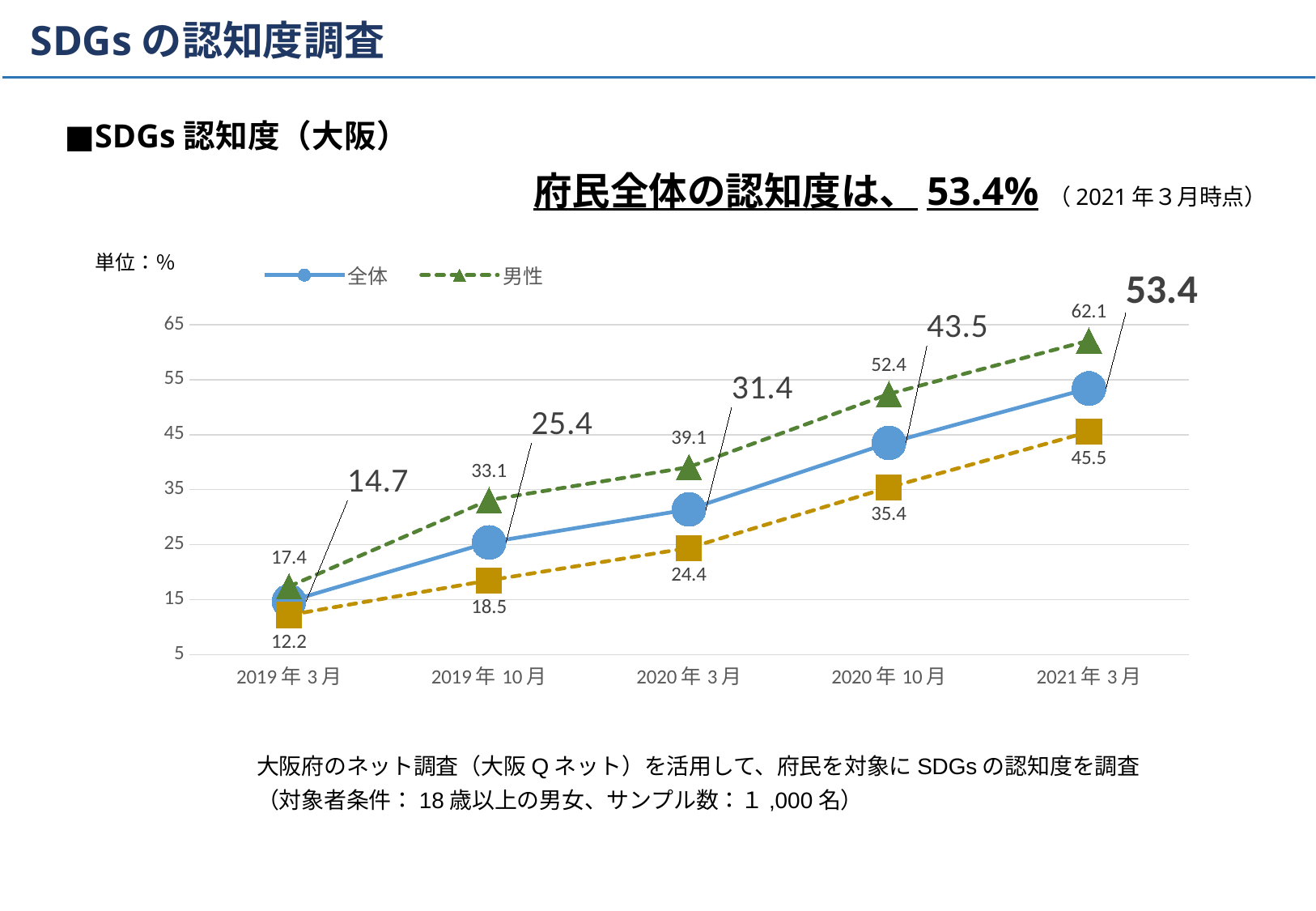
What is the value for 全体 at 2021年3月? 53.4 What is the value for 男性 at 2020年10月? 52.4 At which time point is the 男性 value lowest? 2019年3月 How many time points are plotted on the x axis? 5 What is the value for 全体 at 2019年3月? 14.7 At 2020年3月, which is larger, the 全体 value or the 男性 value? 男性 At which time point is the 全体 value highest? 2021年3月 Does the 全体 value rise or fall from 2019年3月 to 2021年3月? rise What is the difference between the 男性 and 全体 values at 2021年3月? 8.7 By how much did the 全体 value increase from 2019年3月 to 2021年3月? 38.7 What is the value for 男性 at 2019年10月? 33.1 How many series does the legend list? 2